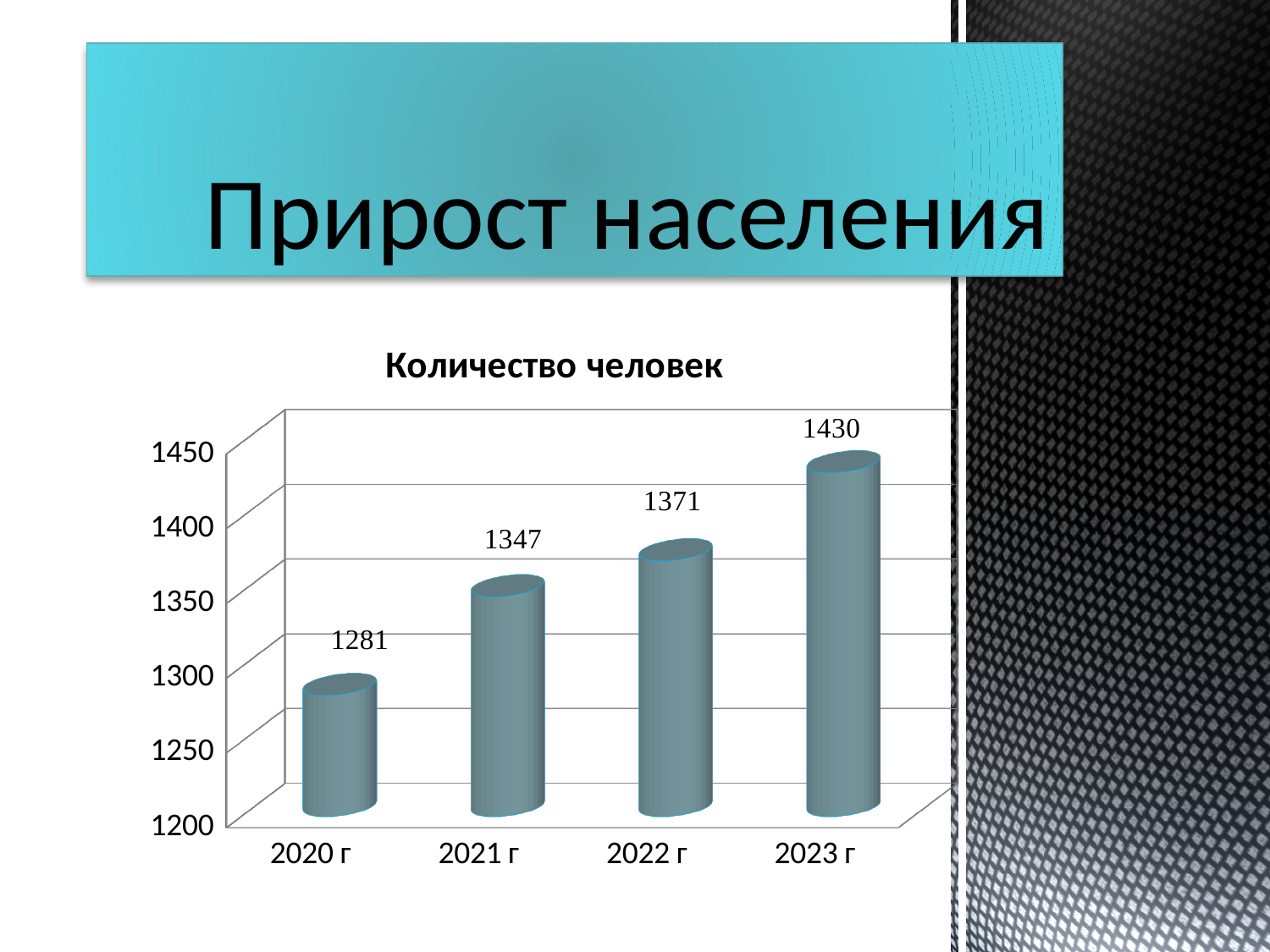
What is the difference between the values for 2021 г and 2020 г? 66 What is the value for 2020 г? 1281 What is the value for 2023 г? 1430 Which year has the lowest value? 2020 г Is the value for 2021 г greater or less than 1300? greater What is the value for 2022 г? 1371 Do the values rise or fall from 2020 г to 2023 г? rise How many years are shown on the x axis? 4 What kind of chart is shown on the slide? bar chart Which is larger, the value for 2021 г or the value for 2022 г? 2022 г What is the difference between the values for 2023 г and 2020 г? 149 Which year has the highest value? 2023 г